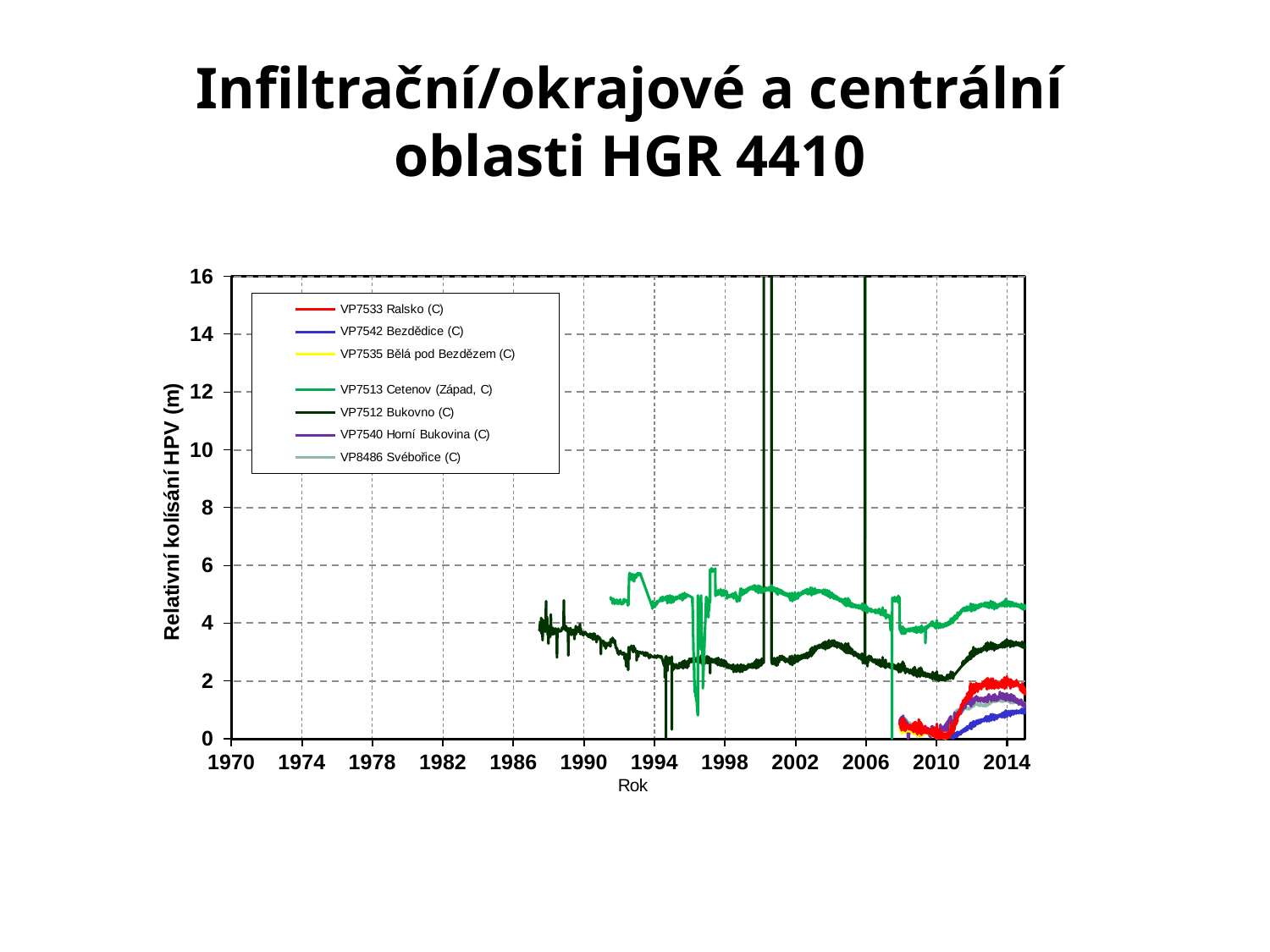
Around 2004, which series has the higher value: VP7513 Cetenov (Západ, C) or VP7512 Bukovno (C)? VP7513 Cetenov (Západ, C) Is the value for VP7542 Bezdědice (C) around 2014 greater or less than 2? less Is the value for VP7512 Bukovno (C) around 2010 greater or less than 4? less Does the VP7533 Ralsko (C) series rise or fall between 2010 and 2013? rise Does the VP7512 Bukovno (C) series rise or fall overall between 1988 and 2010? fall What kind of chart is shown on the slide? line chart Around 2014, which series has the higher value: VP7533 Ralsko (C) or VP7542 Bezdědice (C)? VP7533 Ralsko (C) What is the label of the y axis? Relativní kolísání HPV (m) Is the value for VP7513 Cetenov (Západ, C) around 2002 greater or less than 4? greater What is the label of the x axis? Rok Which series has data starting earliest on the x axis? VP7512 Bukovno (C) How many series does the legend list? 7